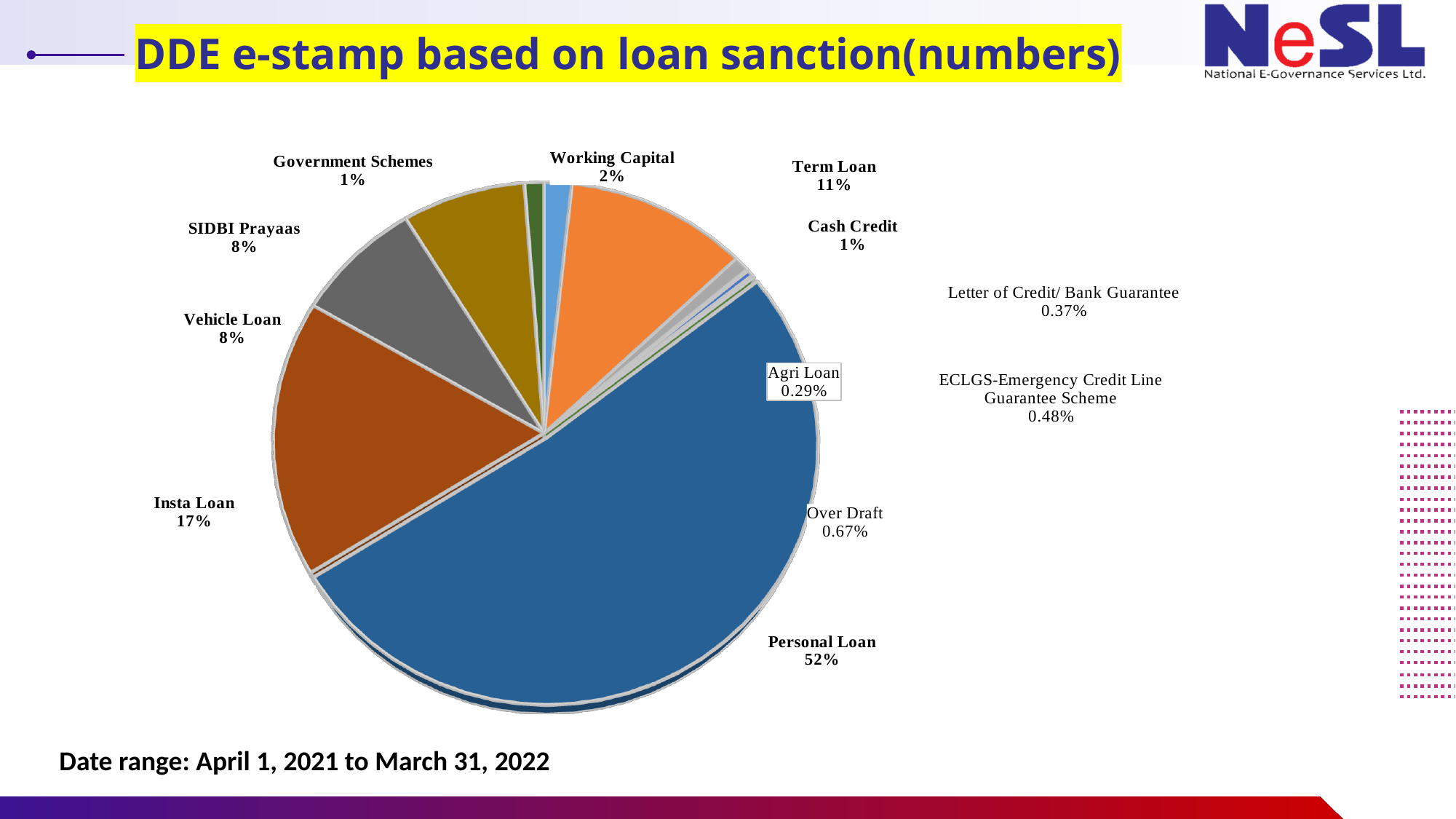
What is the value shown for Agri Loan? 0.29% What type of chart is shown on the slide? Pie chart Which category has the largest share of the pie? Personal Loan Which is larger, Term Loan or Vehicle Loan? Term Loan What is the value shown for Term Loan? 11% What is the value shown for ECLGS-Emergency Credit Line Guarantee Scheme? 0.48% Which is larger, Over Draft or Letter of Credit/ Bank Guarantee? Over Draft How many categories are shown in the pie chart? 12 Which category has the smallest share of the pie? Agri Loan What is the difference in percentage points between Personal Loan and Insta Loan? 35 What is the value shown for Insta Loan? 17% What share of the pie does Personal Loan represent? 52%